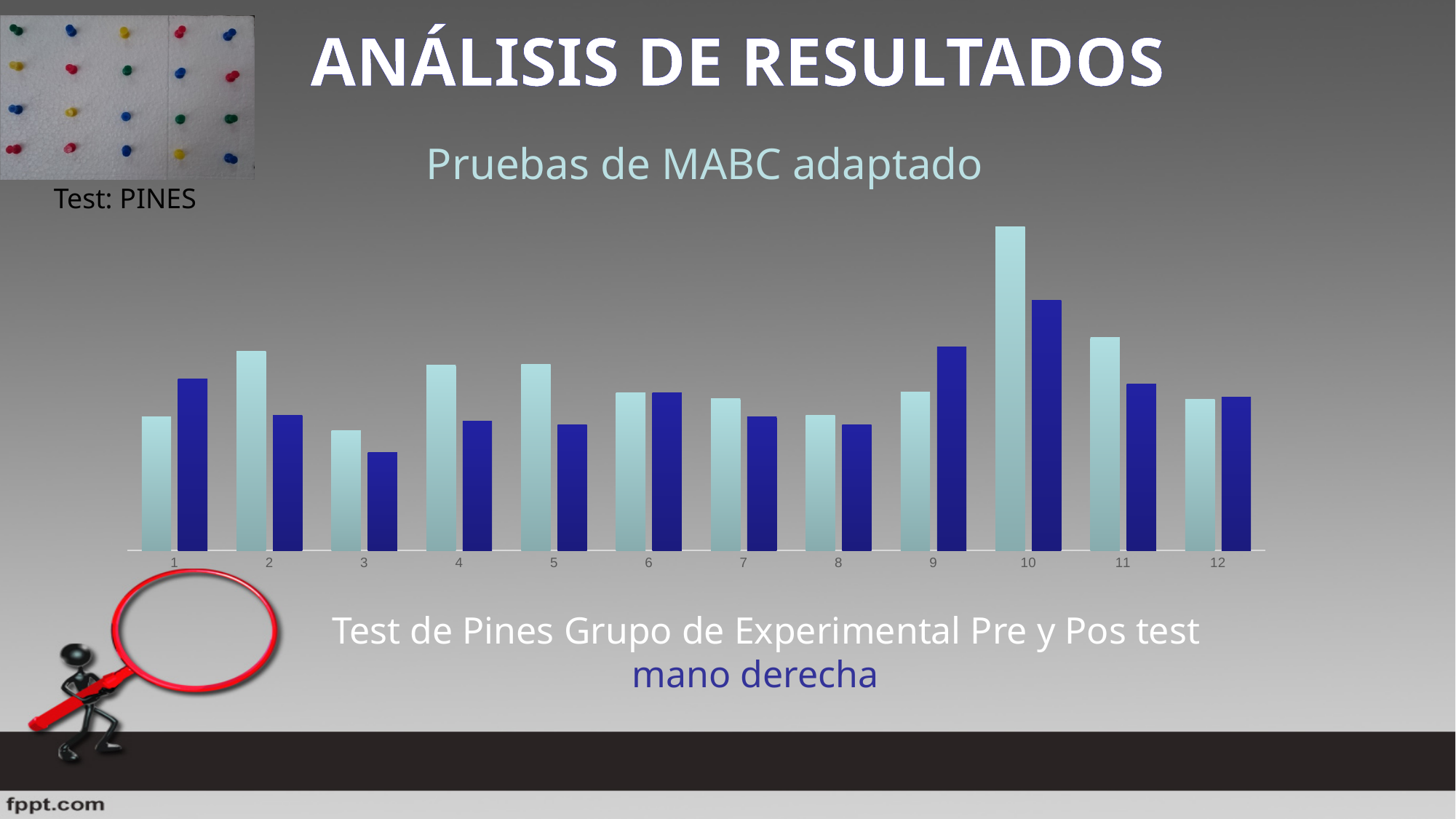
For category 2, which bar is taller, the light blue or the dark blue? light blue Which category has the tallest light blue bar? 10 For category 1, which bar is taller, the light blue or the dark blue? dark blue What caption is written below the chart? Test de Pines Grupo de Experimental Pre y Pos test mano derecha How many bars are shown for each category in the chart? 2 Which category has the tallest dark blue bar? 10 How many categories are shown on the x axis of the chart? 12 Which category has the shortest light blue bar? 3 Which category has the shortest dark blue bar? 3 For category 9, which bar is taller, the light blue or the dark blue? dark blue What kind of chart is shown on the slide? bar chart